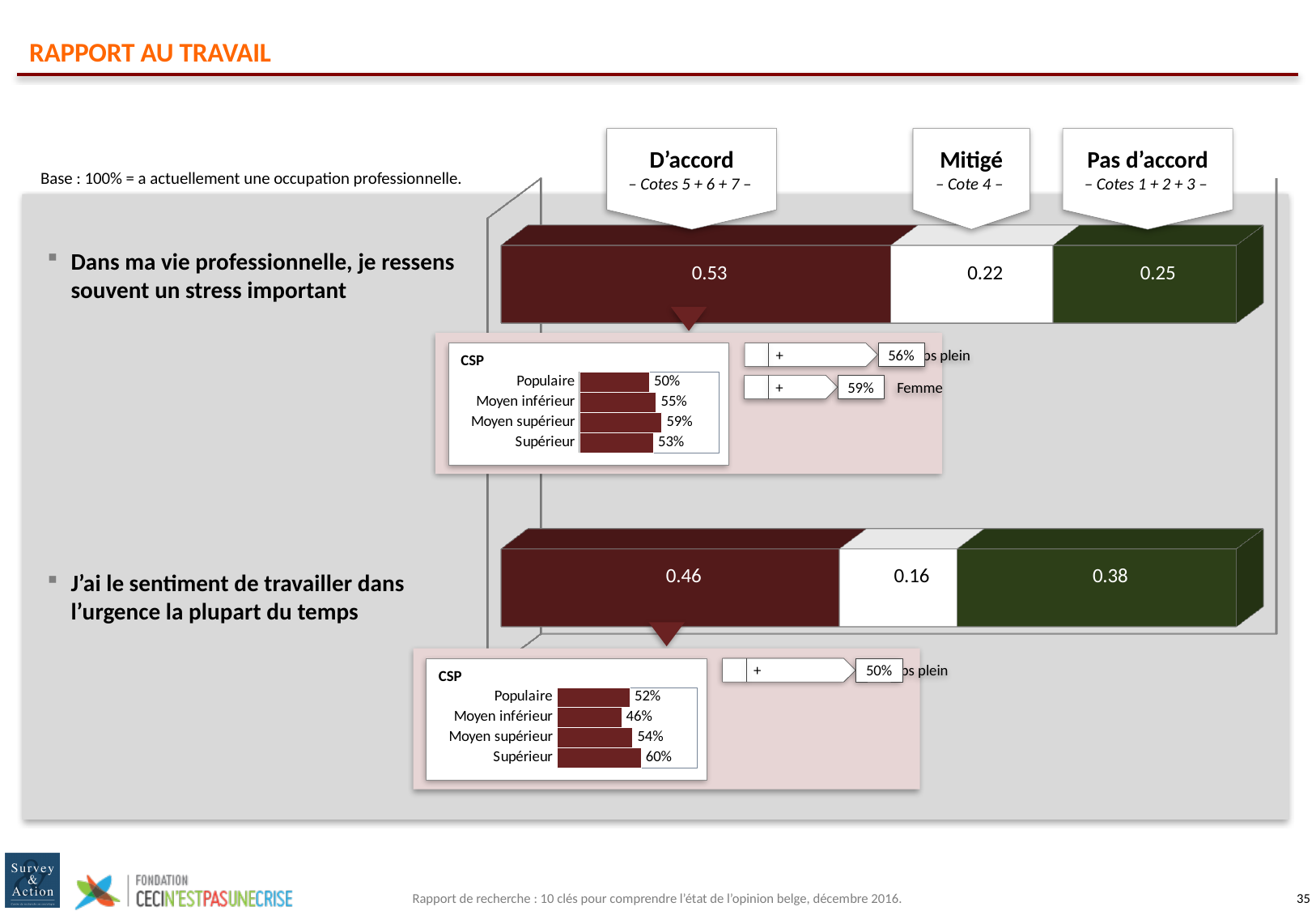
Which statement has the higher D'accord value: the stress statement or the urgence statement? Dans ma vie professionnelle, je ressens souvent un stress important In the CSP chart under the urgence statement, what is the value for Moyen inférieur? 46% In the CSP chart under the stress statement, which category has the lowest value? Populaire How many categories are shown in the CSP chart under the urgence statement? 4 In the stacked bar for "J'ai le sentiment de travailler dans l'urgence la plupart du temps", what is the difference between D'accord and Pas d'accord? 0.08 In the stacked bar for "J'ai le sentiment de travailler dans l'urgence la plupart du temps", what is the value for Mitigé? 0.16 In the CSP chart under the urgence statement, which category has the highest value? Supérieur In the stacked bar for "J'ai le sentiment de travailler dans l'urgence la plupart du temps", which segment is the largest? D'accord What kind of chart is the CSP chart under the stress statement? Bar chart In the stacked bar for "Dans ma vie professionnelle, je ressens souvent un stress important", what is the value for D'accord? 0.53 In the stacked bar for "Dans ma vie professionnelle, je ressens souvent un stress important", what is the value for Pas d'accord? 0.25 In the CSP chart under the stress statement, what is the value for Moyen supérieur? 59%